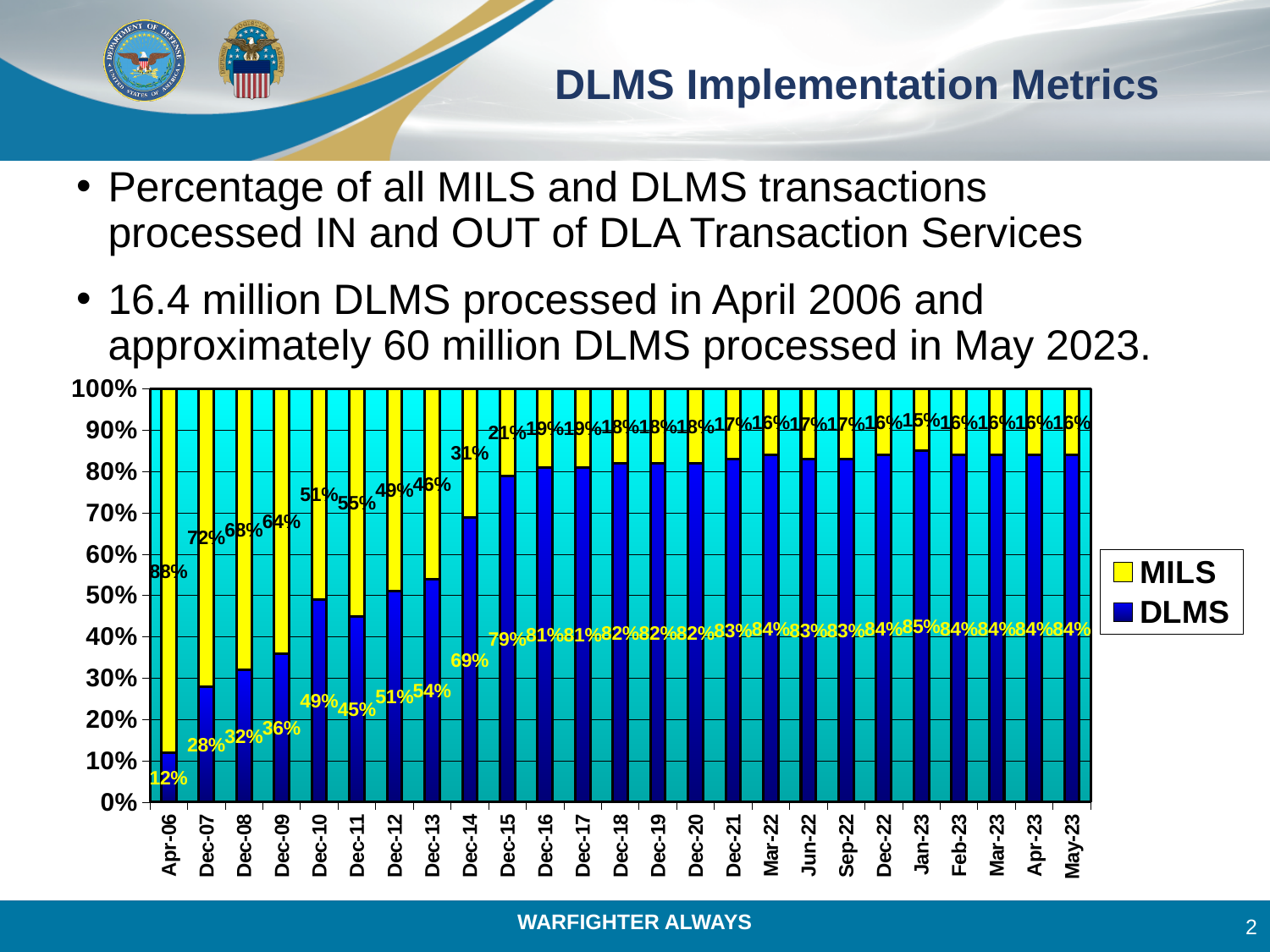
Which is larger, the DLMS percentage for Dec-11 or for Dec-12? Dec-12 What are the two series named in the legend? MILS and DLMS In which period is the DLMS percentage highest? Jan-23 In which period is the MILS percentage lowest? Jan-23 What is the DLMS percentage for Dec-10? 49% What is the MILS percentage for Dec-14? 31% How many series does the legend list? 2 What is the DLMS percentage for Apr-06? 12% Does the DLMS percentage generally rise or fall from Apr-06 to May-23? rise What is the difference between the DLMS percentage in May-23 and in Apr-06? 72% What kind of chart is shown on the slide? stacked bar chart How many time periods are shown along the x axis? 25